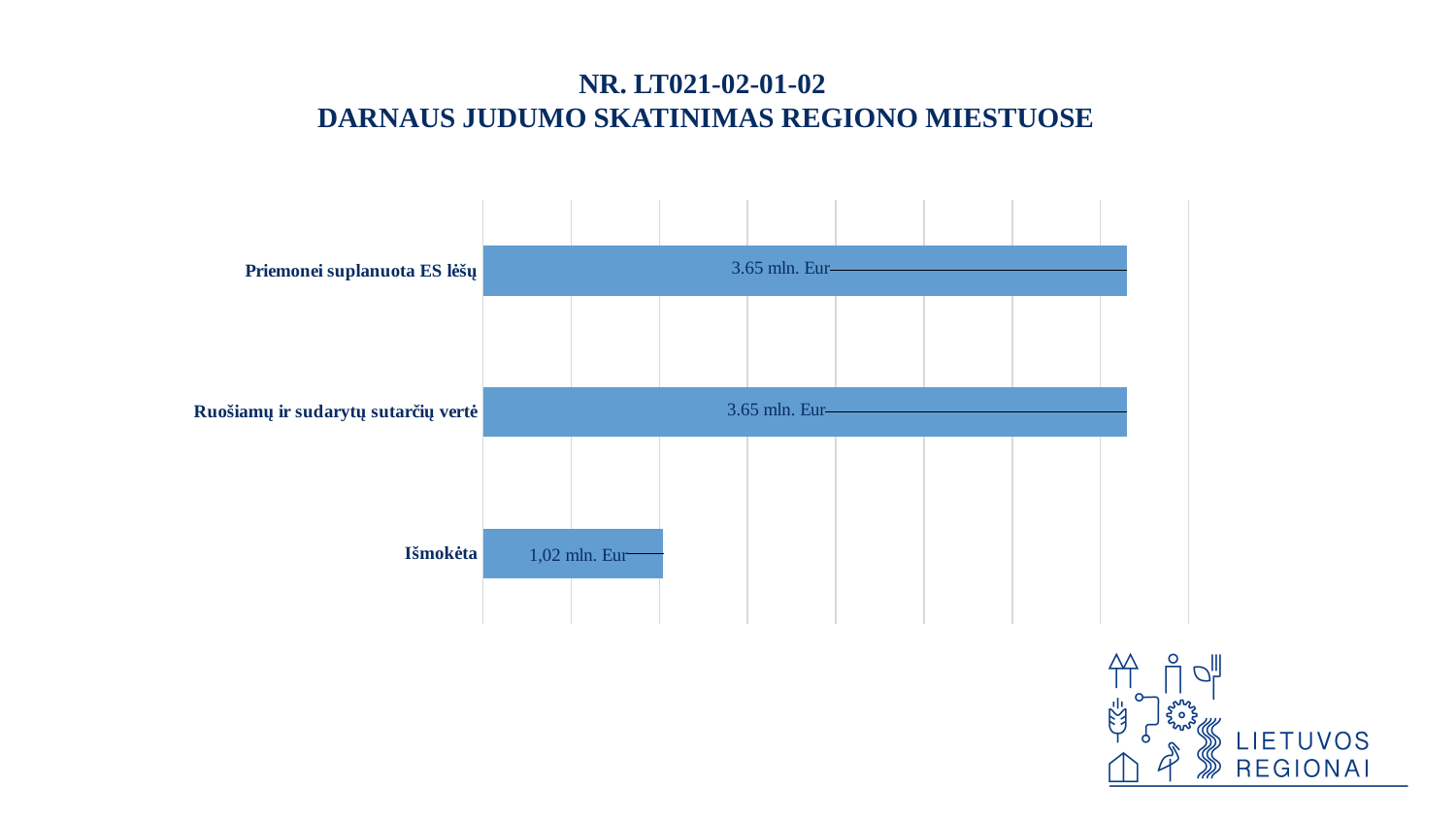
What colour are the bars in the chart? Blue Which is larger: the value for "Priemonei suplanuota ES lėšų" or the value for "Išmokėta"? Priemonei suplanuota ES lėšų What is the value for "Išmokėta"? 1,02 mln. Eur What is the title shown above the chart? NR. LT021-02-01-02 DARNAUS JUDUMO SKATINIMAS REGIONO MIESTUOSE What is the value for "Priemonei suplanuota ES lėšų"? 3.65 mln. Eur How many categories are shown in the chart? 3 What is the value for "Ruošiamų ir sudarytų sutarčių vertė"? 3.65 mln. Eur Which category has the lowest value? Išmokėta What is the difference between the value for "Priemonei suplanuota ES lėšų" and the value for "Išmokėta"? 2.63 mln. Eur What kind of chart is shown on the slide? Bar chart Do "Priemonei suplanuota ES lėšų" and "Ruošiamų ir sudarytų sutarčių vertė" have the same value? Yes Which is larger: the value for "Ruošiamų ir sudarytų sutarčių vertė" or the value for "Išmokėta"? Ruošiamų ir sudarytų sutarčių vertė